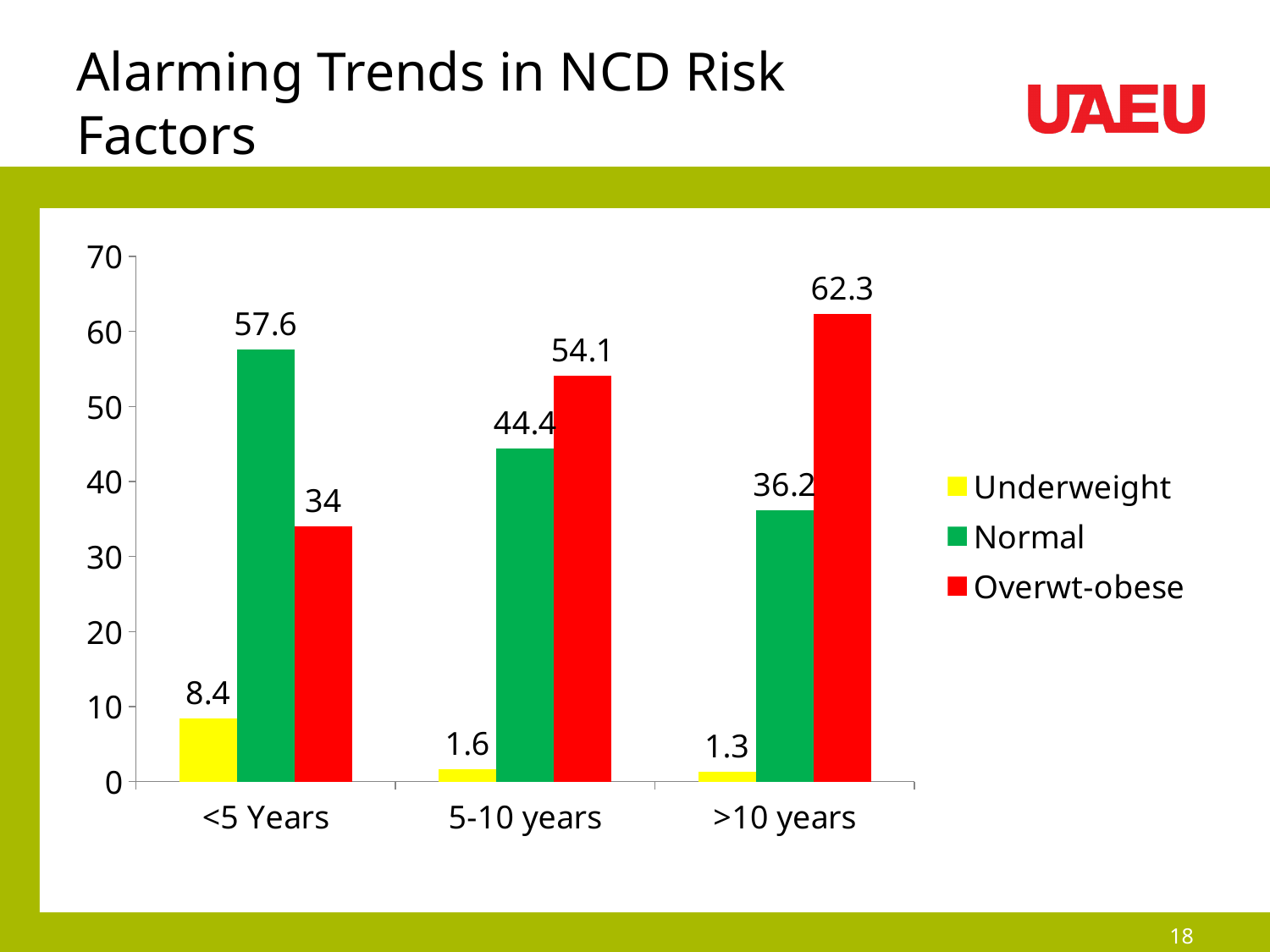
Do the Normal values rise or fall from <5 Years to >10 years? Fall What is the difference between the Overwt-obese values for >10 years and <5 Years? 28.3 What colour represents the Overwt-obese series? Red What is the value for Normal in the <5 Years category? 57.6 How many series does the legend list? 3 What is the value for Overwt-obese in the >10 years category? 62.3 How many categories are shown on the x axis? 3 Which category has the lowest Underweight value? >10 years What kind of chart is shown on the slide? Bar chart What is the value for Underweight in the 5-10 years category? 1.6 Which is larger in the 5-10 years category, Normal or Overwt-obese? Overwt-obese Which category has the highest Overwt-obese value? >10 years